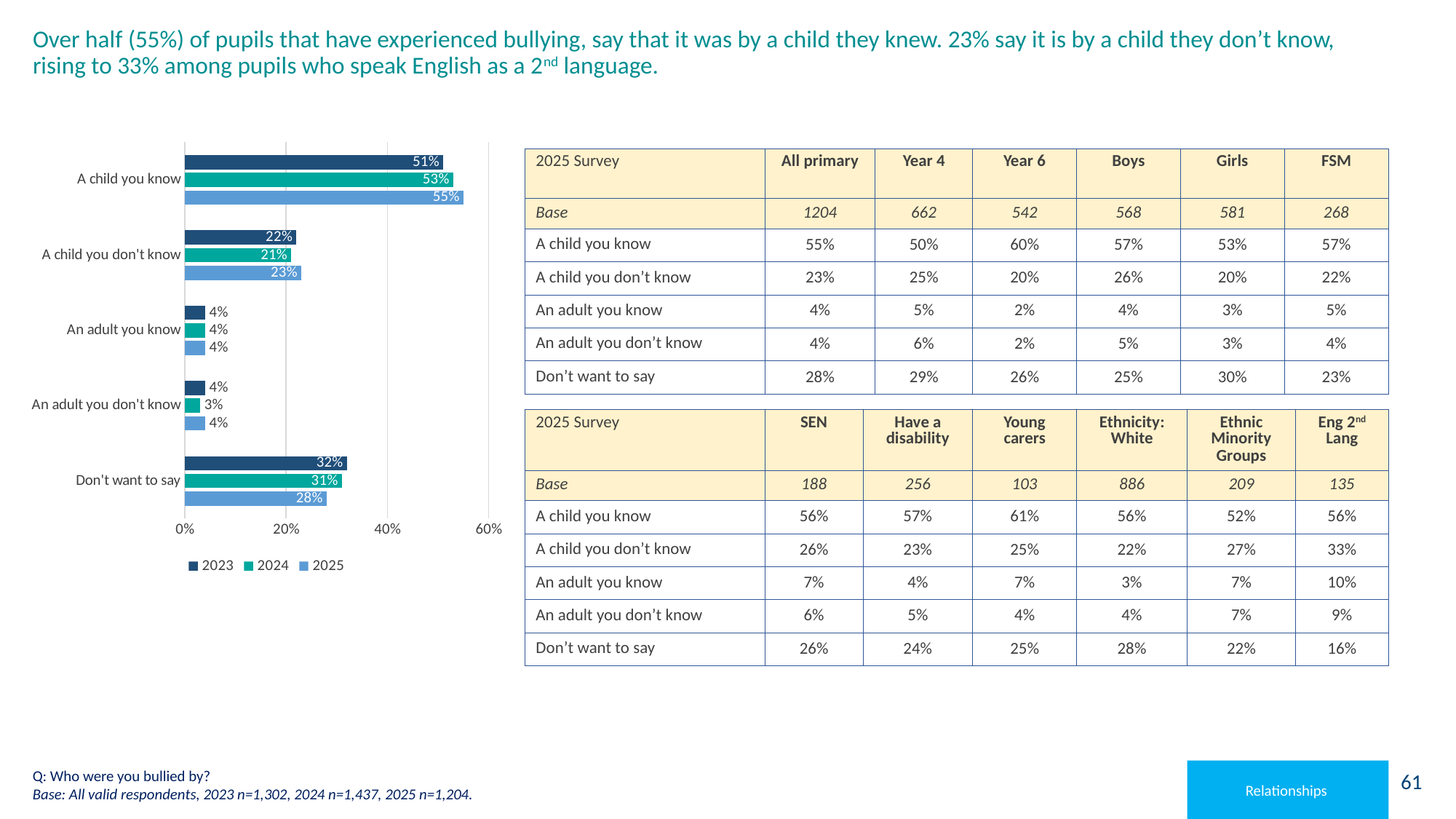
How many categories are shown in the bar chart? 5 How many series does the legend of the bar chart list? 3 What is the 2023 value for 'Don't want to say' in the bar chart? 32% What is the difference between the 2023 and 2025 values for 'Don't want to say' in the bar chart? 4% Which category has the highest 2025 value in the bar chart? A child you know Which years are listed in the legend of the bar chart? 2023, 2024, 2025 What is the 2024 value for 'An adult you don't know' in the bar chart? 3% In the bar chart, is the 2024 value for 'Don't want to say' larger or smaller than the 2025 value? larger What is the 2025 value for 'A child you know' in the bar chart? 55% Is the 2025 value for 'A child you know' in the bar chart greater or less than 40%? greater What kind of chart is shown on the slide? bar chart What is the difference between the 2025 and 2023 values for 'A child you know' in the bar chart? 4%